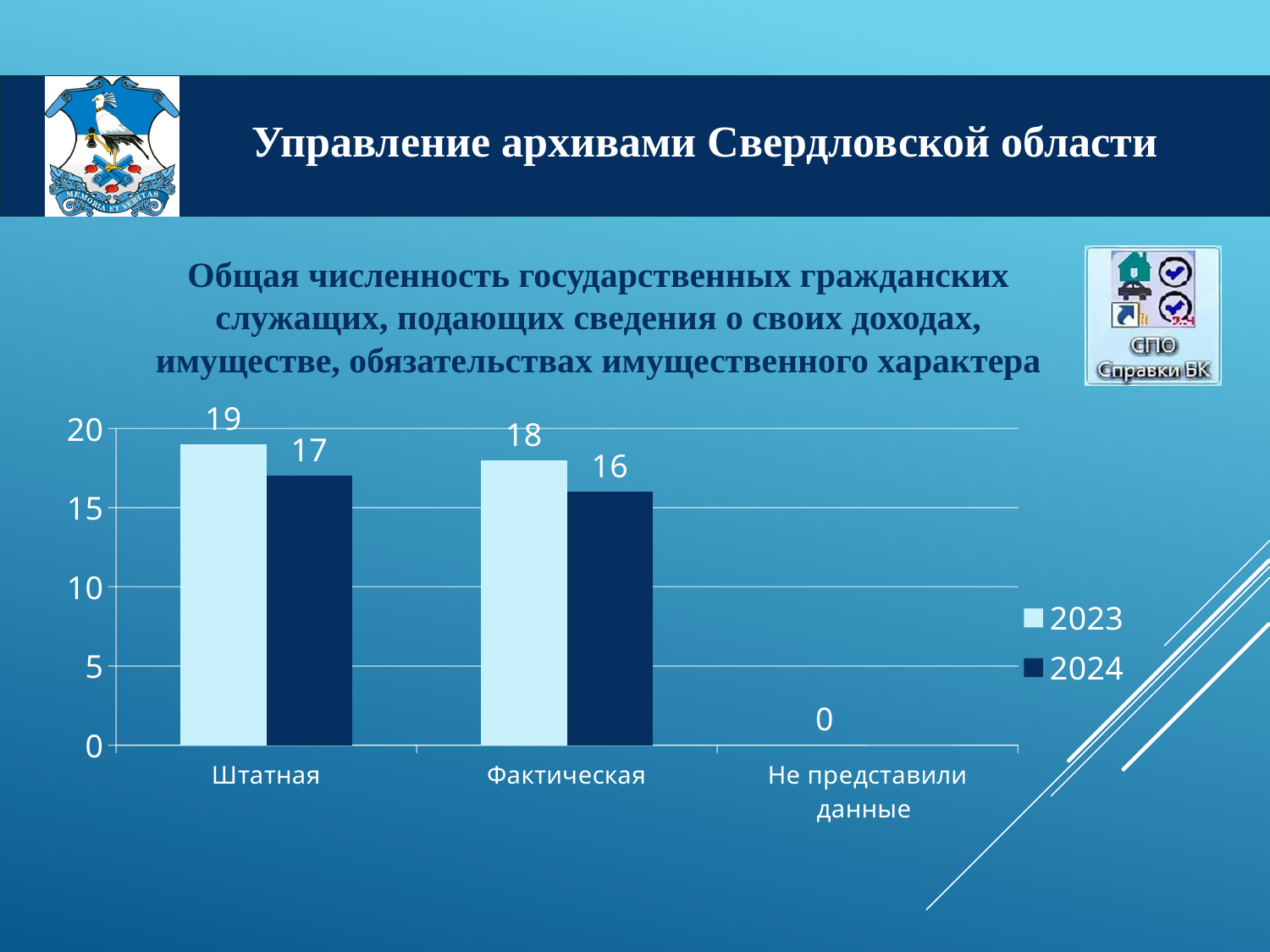
Which category has the highest value for 2023? Штатная What is the difference between the Штатная and Фактическая values for 2024? 1 What kind of chart is shown on the slide? Bar chart What is the value for Фактическая in 2024? 16 What is the value for Фактическая in 2023? 18 What value is shown for Не представили данные? 0 What is the difference between the 2023 and 2024 values for Штатная? 2 How many categories are shown on the x axis? 3 Which is larger: the 2023 value for Фактическая or the 2024 value for Штатная? 2023 value for Фактическая How many series does the legend list? 2 What is the value for Штатная in 2023? 19 What is the value for Штатная in 2024? 17